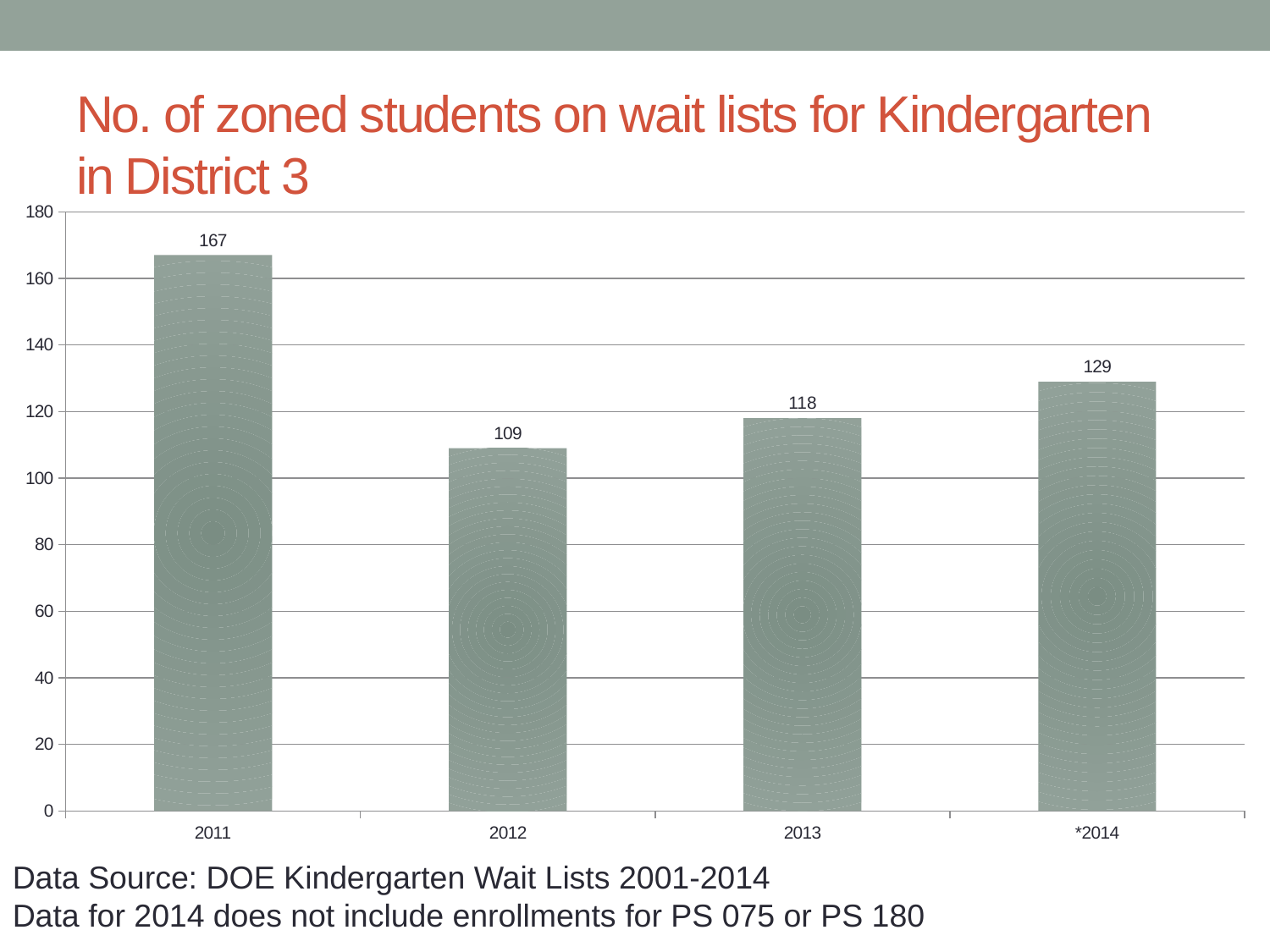
What is the number of zoned students on wait lists for Kindergarten in District 3 in 2011? 167 What is the difference between the number of students on wait lists in *2014 and in 2013? 11 What is the number of zoned students on wait lists for Kindergarten in District 3 in 2013? 118 What kind of chart is shown on the slide? bar chart What is the number of zoned students on wait lists for Kindergarten in District 3 in 2012? 109 Does the number of zoned students on wait lists rise or fall from 2012 to *2014? rise What is the difference between the number of students on wait lists in 2011 and in 2012? 58 Which year has more zoned students on wait lists, 2013 or *2014? *2014 What is the number of zoned students on wait lists for Kindergarten in District 3 in *2014? 129 How many years are shown on the x axis of the chart? 4 Which year has the lowest number of zoned students on wait lists? 2012 Which year has the highest number of zoned students on wait lists? 2011